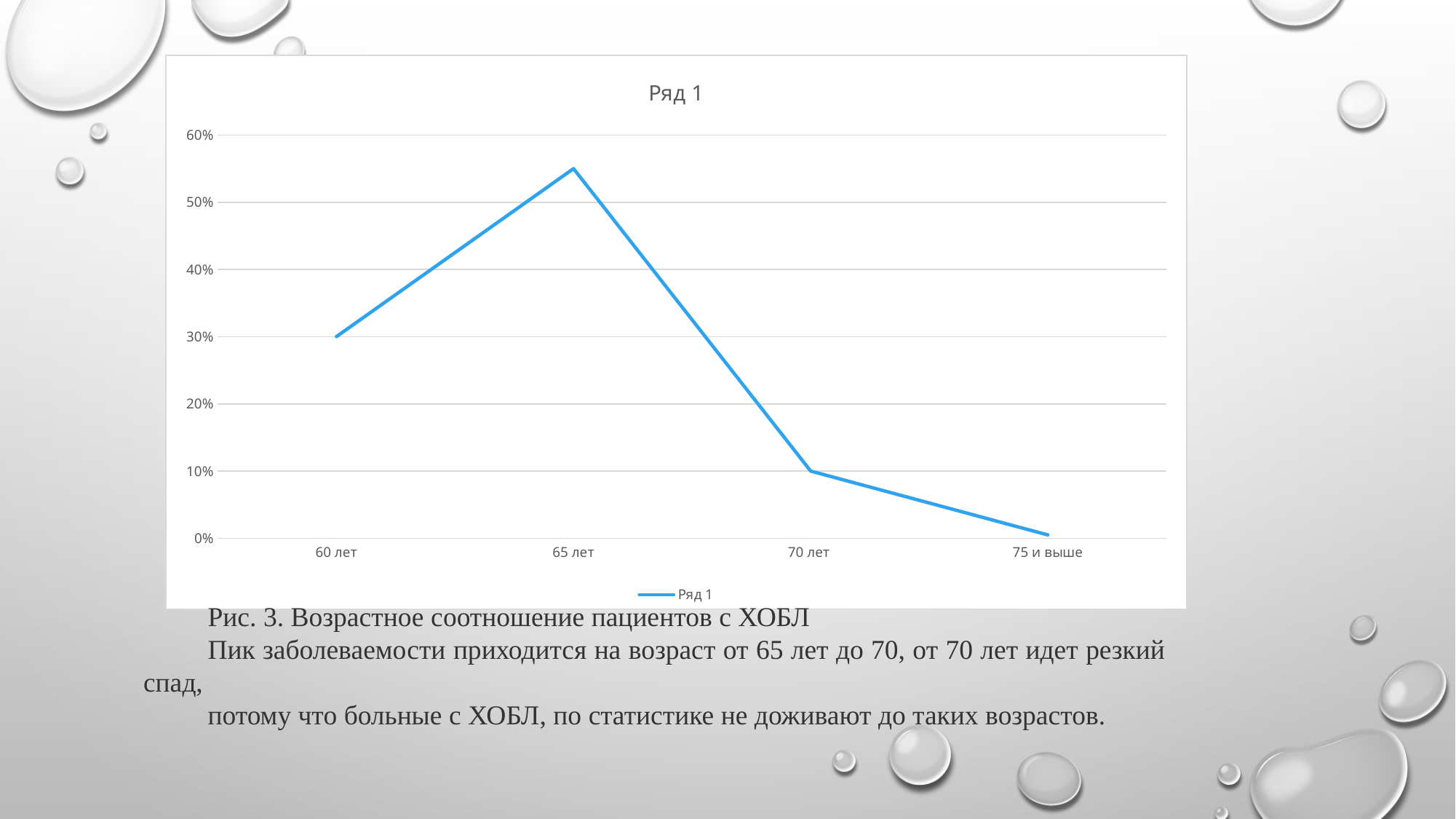
What is the value for 70 лет? 10% How many series does the legend list? 1 Which age category has the lowest value? 75 и выше What is the difference between the values for 60 лет and 70 лет? 20% How many age categories are plotted along the x axis? 4 Which age category has the highest value? 65 лет Is the value for 65 лет greater or less than 50%? greater Is the value for 75 и выше greater or less than 10%? less Which has the larger value, 60 лет or 70 лет? 60 лет What is the value for 60 лет? 30% What kind of chart is shown on the slide? line chart Do the values rise or fall from 65 лет to 75 и выше? fall